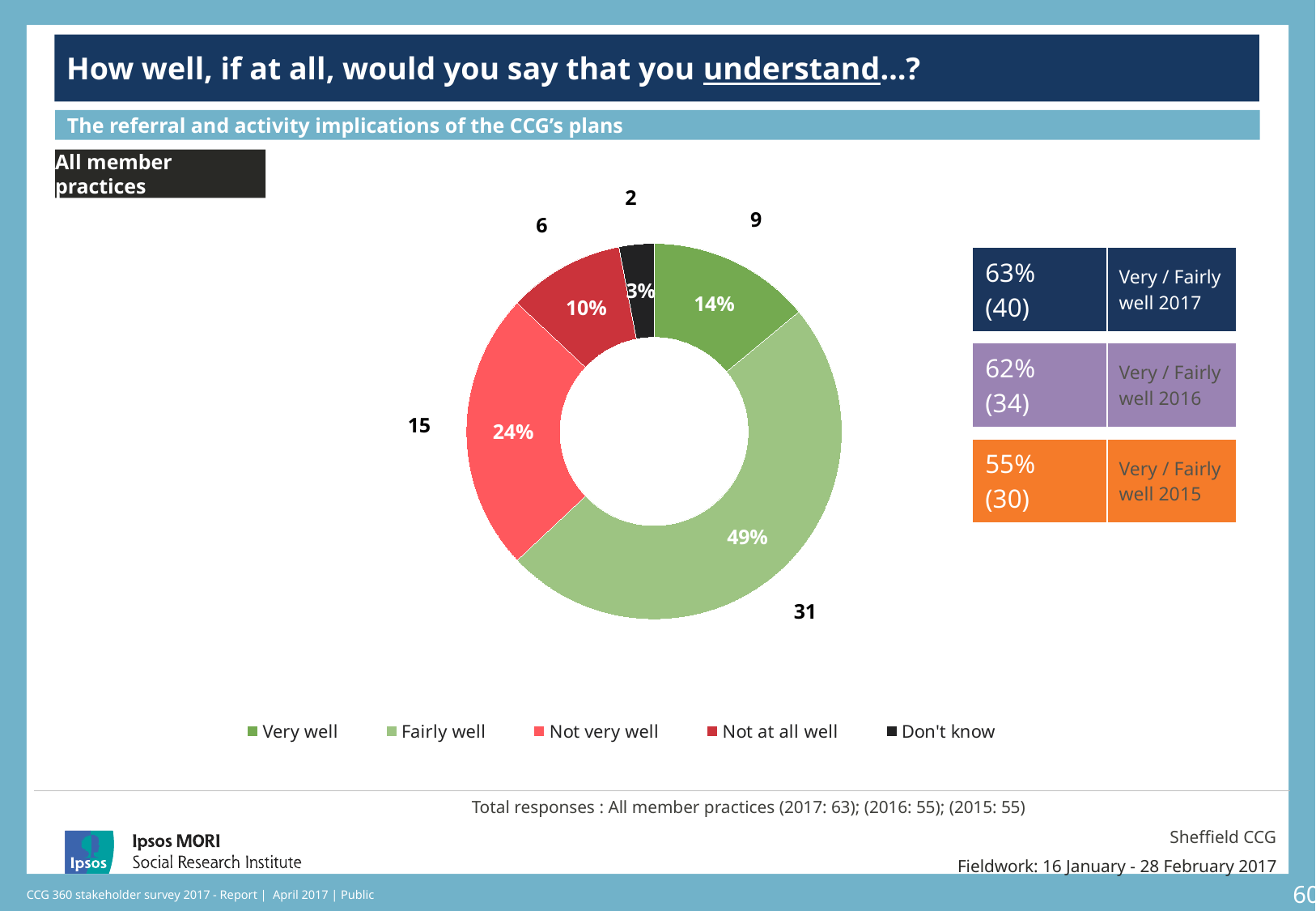
What is the difference in percentage points between 'Fairly well' and 'Not very well'? 25 What was the 'Very / Fairly well' percentage in 2015? 55% How many response categories does the legend list? 5 Which is larger, the share for 'Very well' or the share for 'Not at all well'? Very well What percentage of respondents answered 'Not very well'? 24% What is the combined number of respondents who answered 'Very well' or 'Fairly well' in 2017? 40 What kind of chart is shown on the slide? Donut (pie) chart How many respondents answered 'Very well'? 9 What percentage of respondents answered 'Don't know'? 3% What percentage of respondents said they understand the referral and activity implications 'Fairly well'? 49% Which response category has the largest share of the chart? Fairly well Which response category has the smallest share of the chart? Don't know